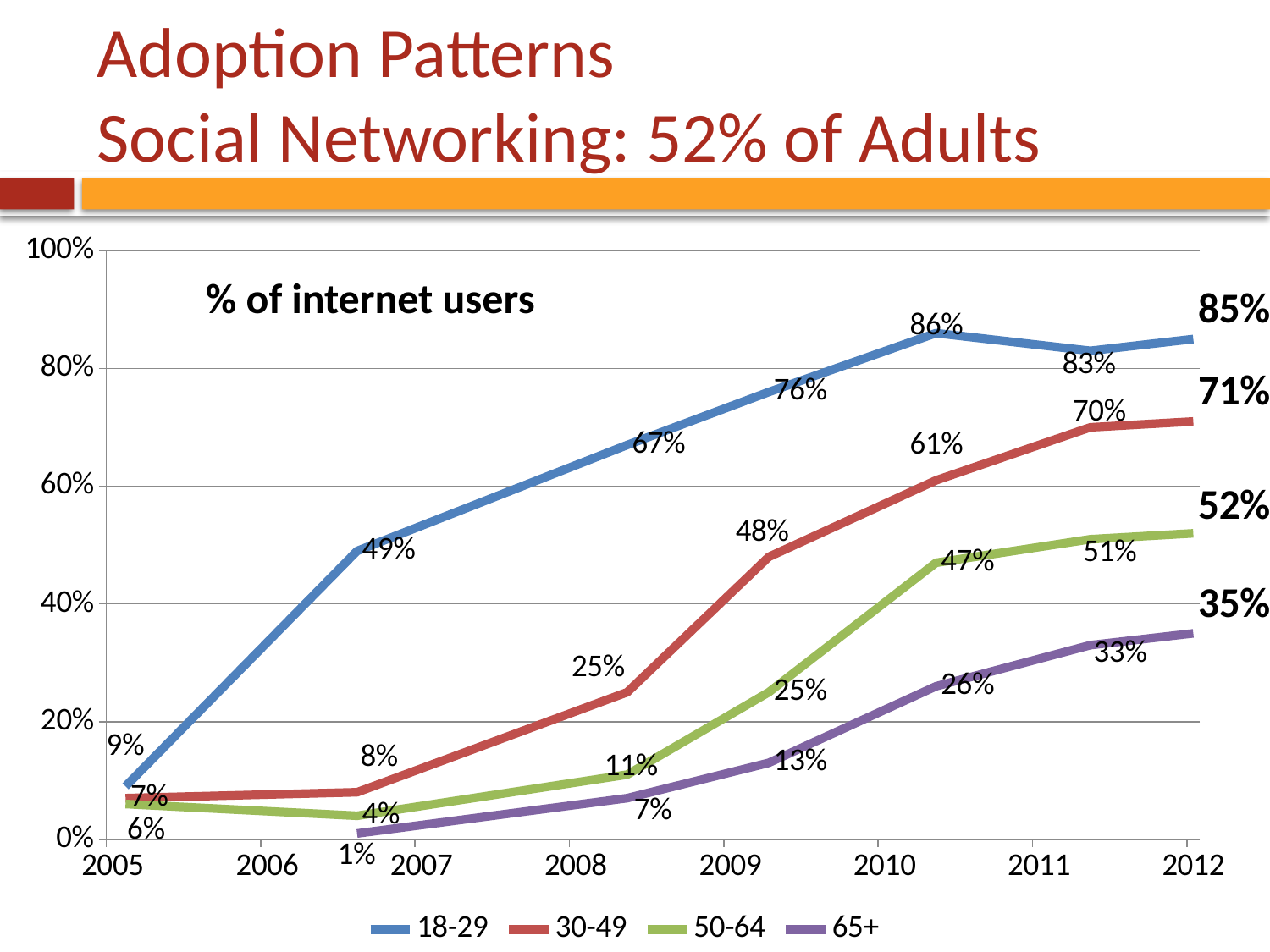
Which age group has the lowest value in 2012? 65+ What is the value for the 65+ series in 2012? 35% What kind of chart is shown on the slide? line chart What is the difference between the 18-29 and 30-49 values in 2012? 14 percentage points Which age group has the highest value in 2012? 18-29 What is the value for the 30-49 series in 2010? 61% Does the 30-49 series rise or fall from 2005 to 2012? rise What is the value for the 18-29 series in 2012? 85% Which is larger in 2012, the 50-64 value or the 30-49 value? 30-49 How many series does the legend list? 4 What is the value for the 50-64 series in 2011? 51% What is the value for the 18-29 series in 2005? 9%